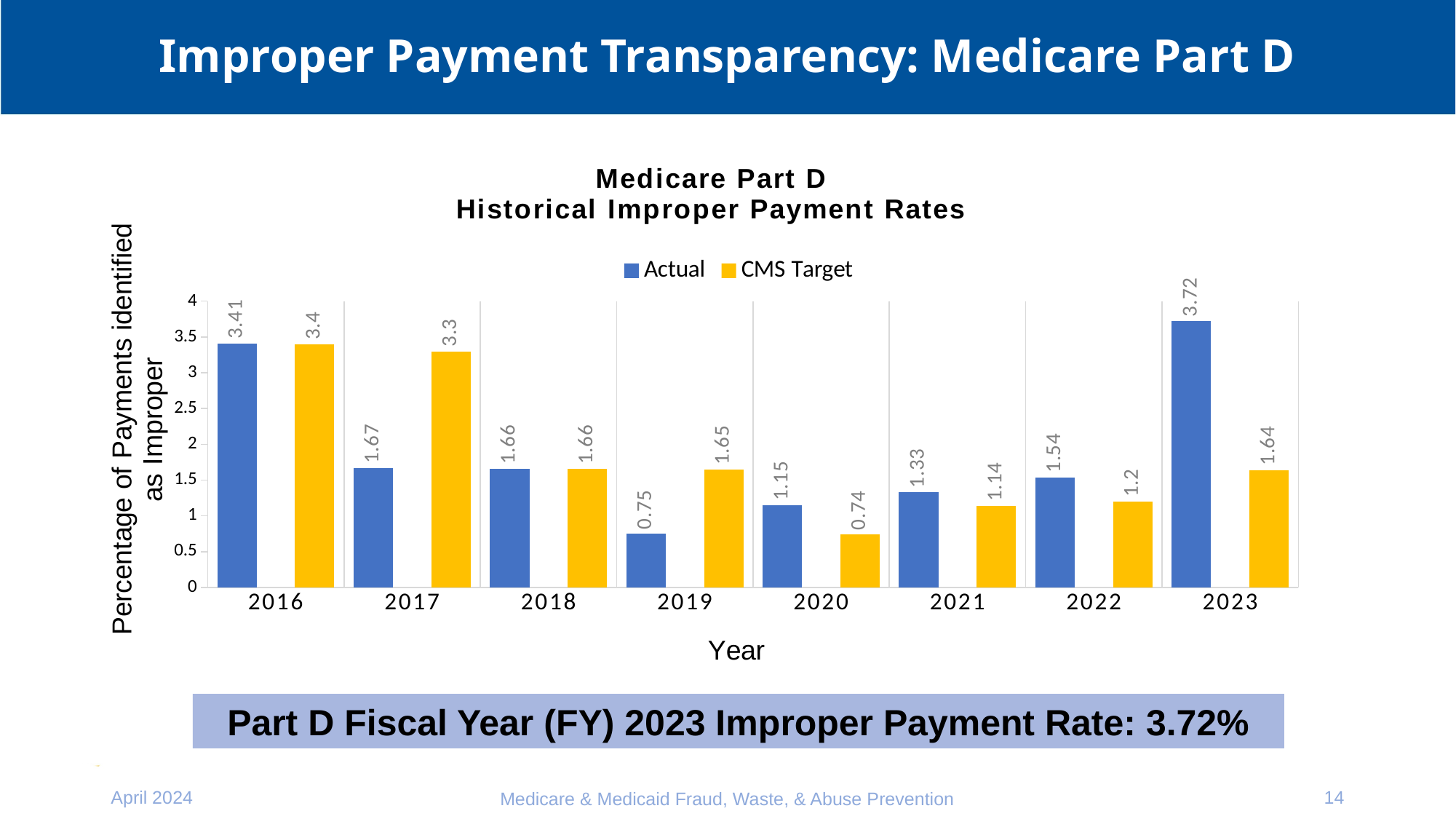
What is the title of the chart? Medicare Part D Historical Improper Payment Rates Which year has the highest Actual value? 2023 What kind of chart is shown on the slide? Bar chart Which is larger for 2019, the Actual value or the CMS Target value? CMS Target Does the Actual value rise or fall from 2022 to 2023? Rise What is the difference between the Actual and CMS Target values for 2023? 2.08 What is the CMS Target value for 2017? 3.3 Which year has the lowest CMS Target value? 2020 What is the Actual improper payment rate for 2023? 3.72 How many years are shown on the x axis? 8 What is the Actual value for 2019? 0.75 How many series does the legend list? 2